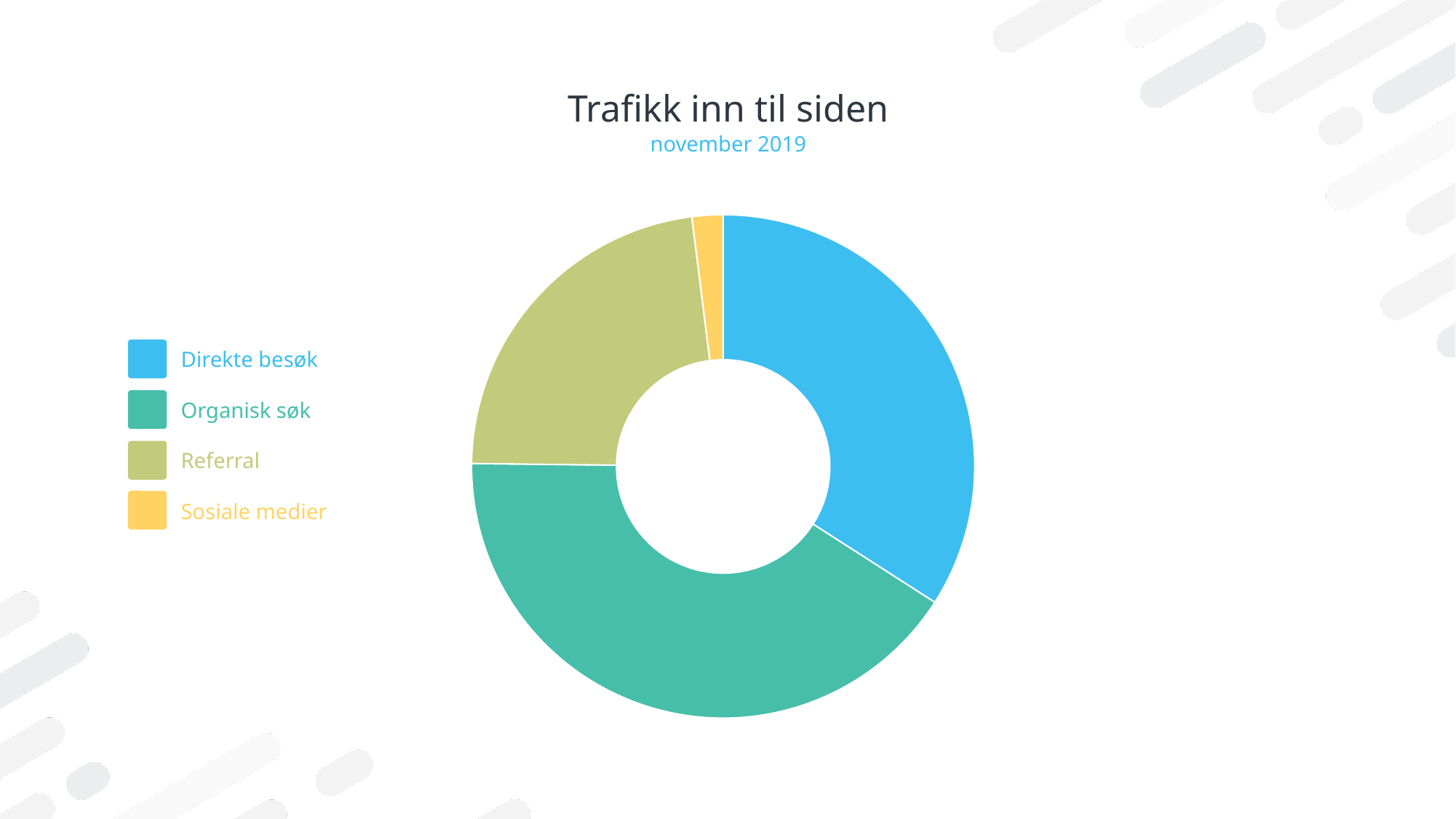
Which category has the smallest share of the chart? Sosiale medier Which is larger, the share for Organisk søk or the share for Referral? Organisk søk Which is larger, the share for Direkte besøk or the share for Referral? Direkte besøk Which is larger, the share for Referral or the share for Sosiale medier? Referral What kind of chart is shown on the slide? Pie chart (donut) What is the title of the chart? Trafikk inn til siden How many categories does the chart show? 4 Which category has the largest share of the chart? Organisk søk Which month and year does the chart subtitle refer to? november 2019